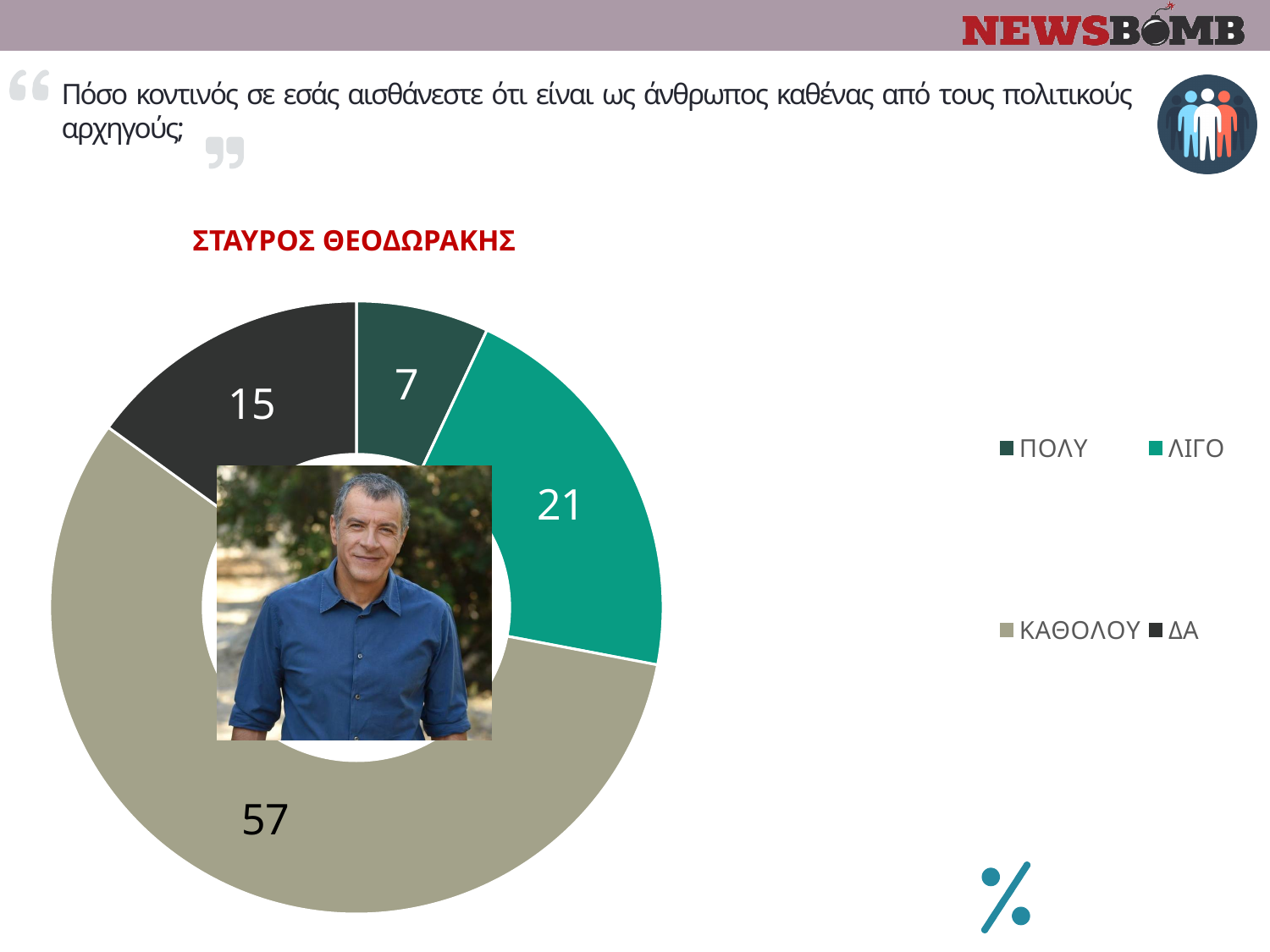
What is the value for ΔΑ? 15 What is the value for ΛΙΓΟ? 21 What is the value for ΠΟΛΥ? 7 Which politician is the chart about? ΣΤΑΥΡΟΣ ΘΕΟΔΩΡΑΚΗΣ What type of chart is shown on the slide? Doughnut (pie) chart Which category has the smallest share? ΠΟΛΥ How many categories does the chart show? 4 Which category has the largest share? ΚΑΘΟΛΟΥ What is the difference between the values for ΚΑΘΟΛΟΥ and ΛΙΓΟ? 36 What is the total of the values for ΠΟΛΥ and ΛΙΓΟ? 28 Which is larger, the value for ΔΑ or the value for ΠΟΛΥ? ΔΑ What is the value for ΚΑΘΟΛΟΥ? 57